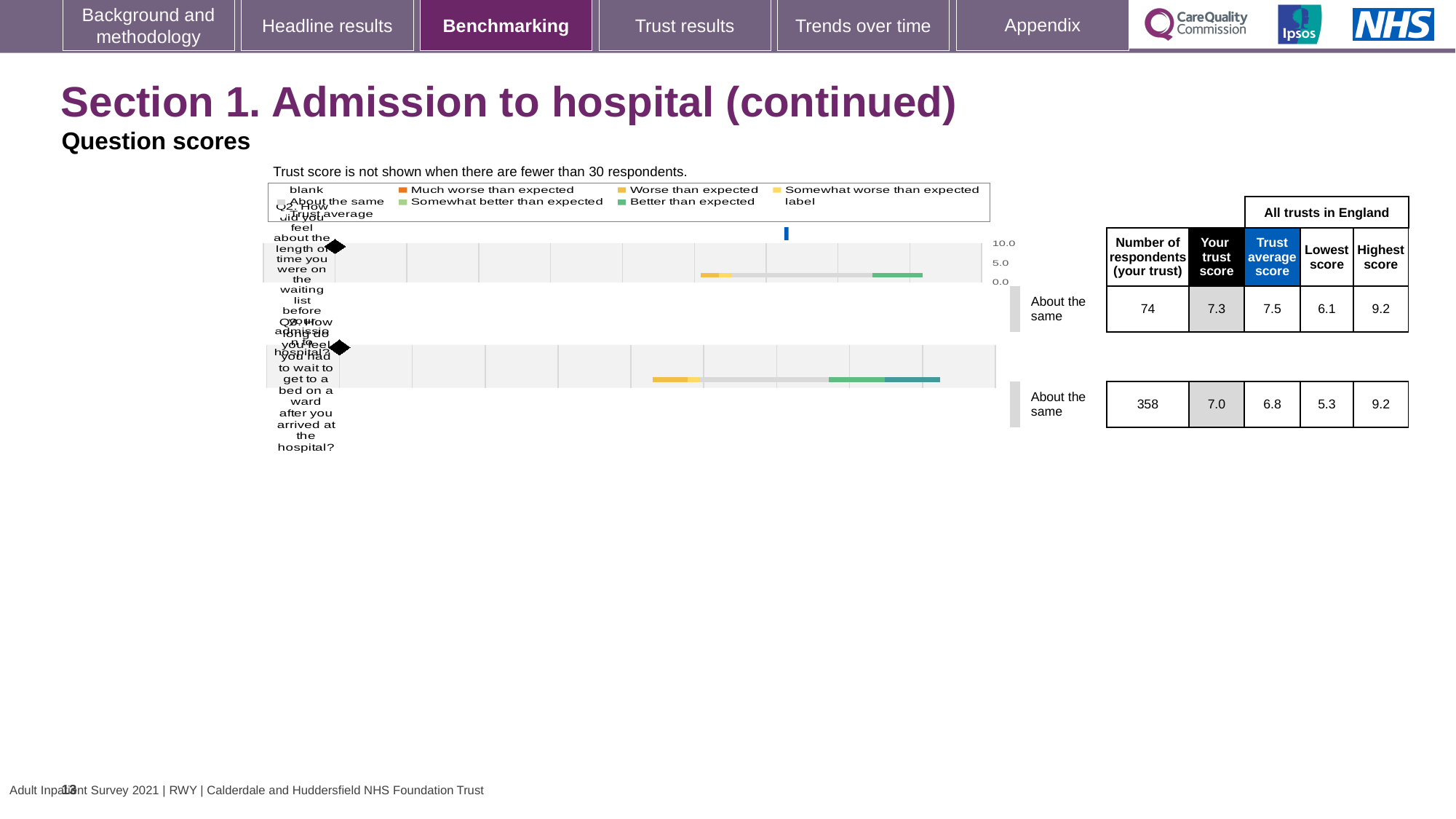
What is the highest score across all trusts in England for Q2? 9.2 What is the 'Your trust score' for Q3 (wait to get to a bed on a ward after arriving at the hospital)? 7.0 How many respondents answered Q3 for this trust? 358 What is the lowest score across all trusts in England for Q3? 5.3 How many respondents answered Q2 for this trust? 74 What is the trust average score across all trusts in England for Q2? 7.5 What benchmark category is shown for Q3? About the same For Q2, which is larger: this trust's score or the trust average score? Trust average score What is the 'Your trust score' for Q2 (length of time on the waiting list before admission)? 7.3 For Q3, how much higher is this trust's score than the trust average score? 0.2 How many questions are plotted on the slide? 2 What kind of chart is used to show the question scores? Bar chart